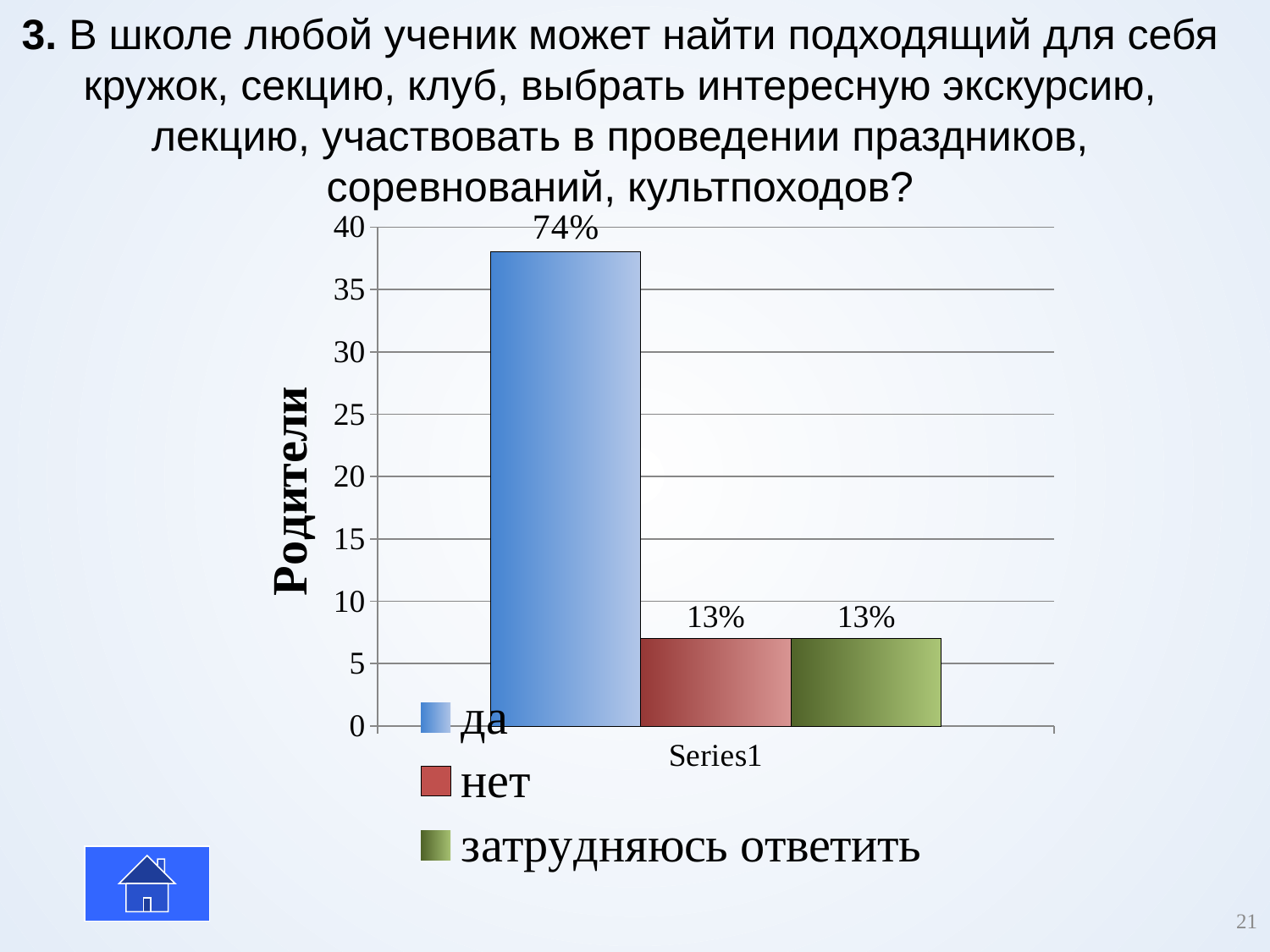
Which legend entry has the highest bar? да How many series does the legend list? 3 Is the bar for "нет" greater or less than 10 on the vertical axis? less What kind of chart is shown on the slide? bar chart What data label is shown on the bar for "затрудняюсь ответить"? 13% What data label is shown on the bar for "нет"? 13% What data label is shown on the bar for "да"? 74% What colour is the bar for "затрудняюсь ответить"? green What is the difference between the data labels for "да" and "нет"? 61% What is the label on the vertical axis of the chart? Родители Which is larger, the value for "да" or the value for "нет"? да Is the bar for "да" greater or less than 35 on the vertical axis? greater